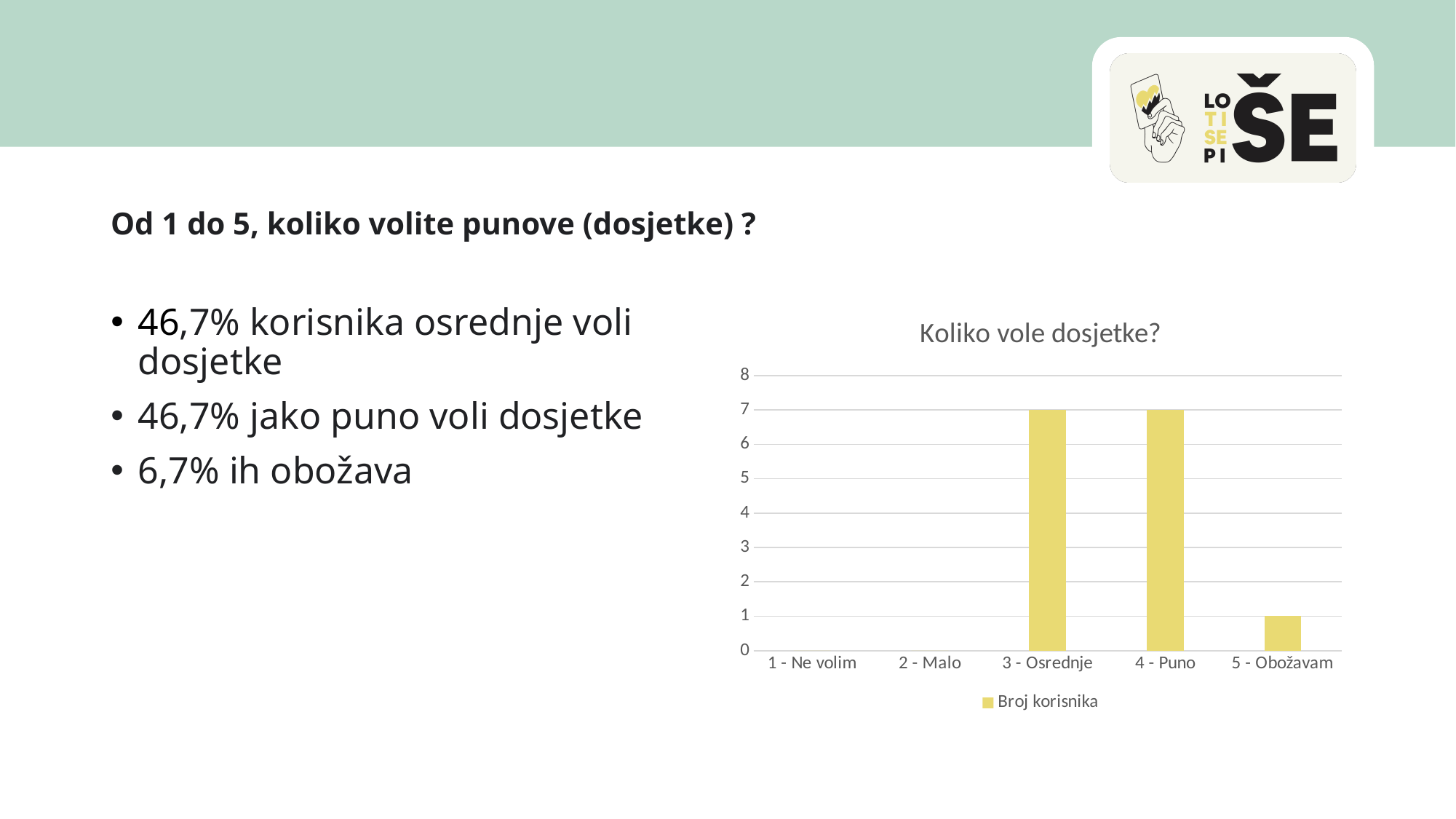
Is the value for 4 - Puno greater or less than 5? greater Which is larger, the value for 3 - Osrednje or the value for 5 - Obožavam? 3 - Osrednje What is the value for 5 - Obožavam? 1 What is the value for 2 - Malo? 0 What is the difference between the value for 4 - Puno and the value for 5 - Obožavam? 6 What is the value for 1 - Ne volim? 0 What kind of chart is shown? bar chart How many categories are shown on the x axis? 5 What is the value for 3 - Osrednje? 7 Is the value for 5 - Obožavam greater or less than 3? less How many series does the legend list? 1 What is the value for 4 - Puno? 7